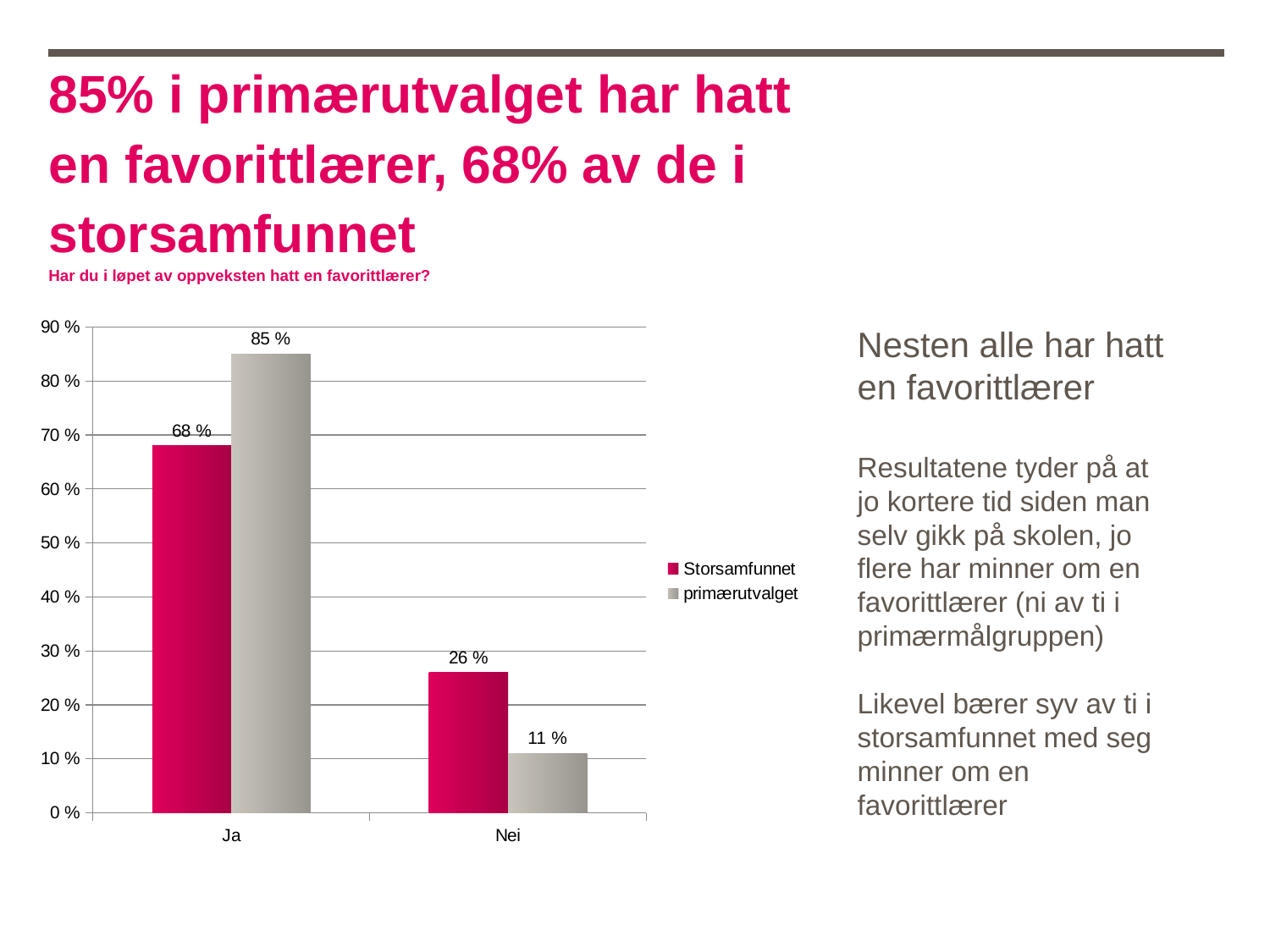
Which series has the higher value in the Ja category? primærutvalget What is the value for Storsamfunnet in the Ja category? 68 % What is the value for primærutvalget in the Ja category? 85 % What is the value for primærutvalget in the Nei category? 11 % Which bar in the chart has the lowest value? primærutvalget, Nei How many series does the legend list? 2 Which bar in the chart has the highest value? primærutvalget, Ja What is the difference between the primærutvalget and Storsamfunnet values in the Ja category? 17 % What kind of chart is shown on the slide? Bar chart What is the value for Storsamfunnet in the Nei category? 26 % What is the difference between the Storsamfunnet and primærutvalget values in the Nei category? 15 % Which series has the higher value in the Nei category? Storsamfunnet